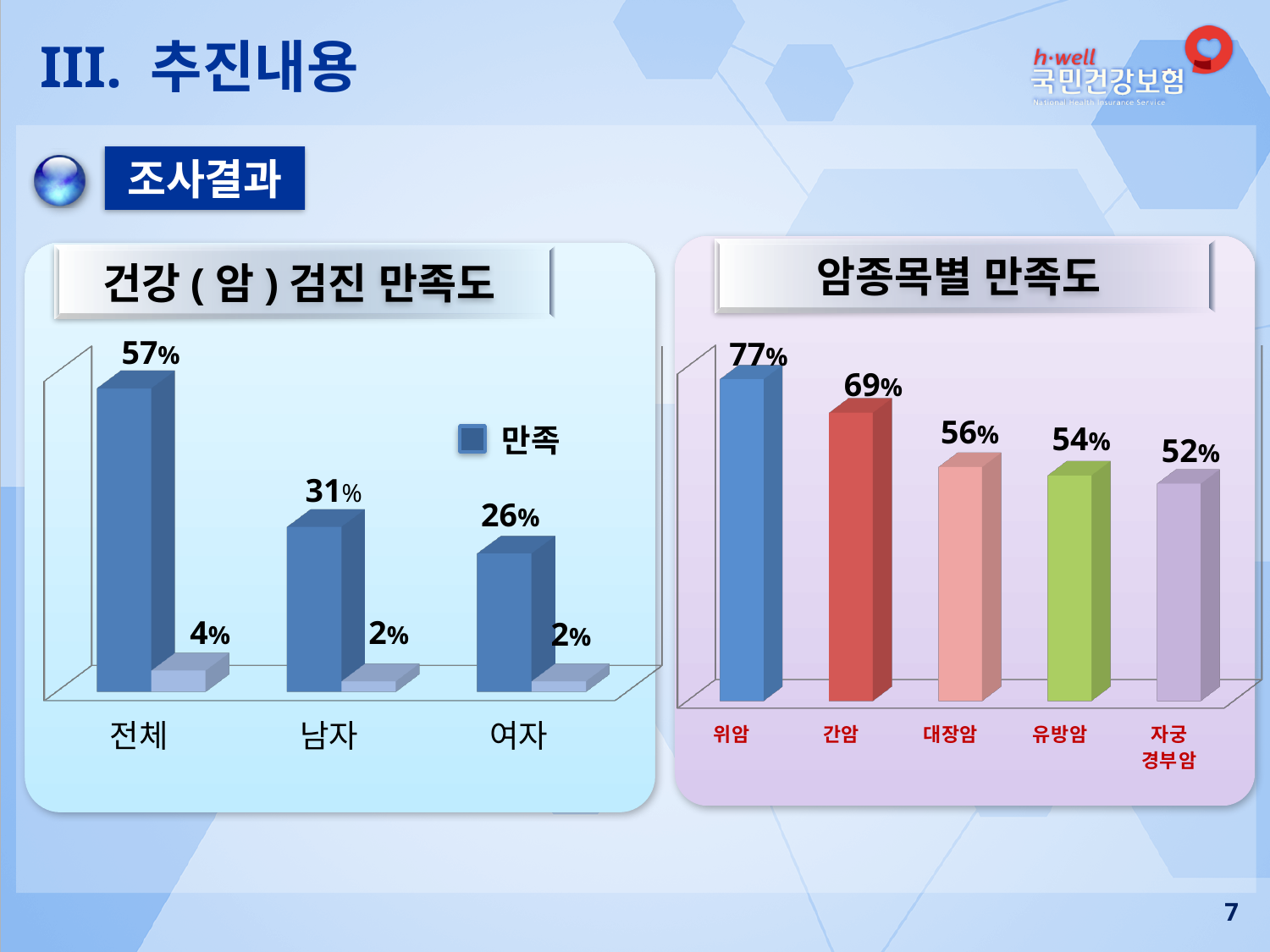
In the chart titled 건강 ( 암 ) 검진 만족도, what is the 만족 value for 남자? 31% In the chart titled 건강 ( 암 ) 검진 만족도, how many categories are shown on the x axis? 3 In the chart titled 건강 ( 암 ) 검진 만족도, what series name does the legend show? 만족 In the chart titled 암종목별 만족도, which category has the lowest value? 자궁경부암 In the chart titled 건강 ( 암 ) 검진 만족도, what is the 만족 value for 여자? 26% In the chart titled 건강 ( 암 ) 검진 만족도, what is the difference between the 만족 values for 남자 and 여자? 5% In the chart titled 건강 ( 암 ) 검진 만족도, which category has the highest 만족 value? 전체 In the chart titled 건강 ( 암 ) 검진 만족도, what is the 만족 value for 전체? 57% In the chart titled 암종목별 만족도, what is the value for 대장암? 56% In the chart titled 암종목별 만족도, do the values rise or fall from left to right along the x axis? fall In the chart titled 암종목별 만족도, what is the value for 위암? 77% In the chart titled 암종목별 만족도, what is the difference between the values for 위암 and 간암? 8%